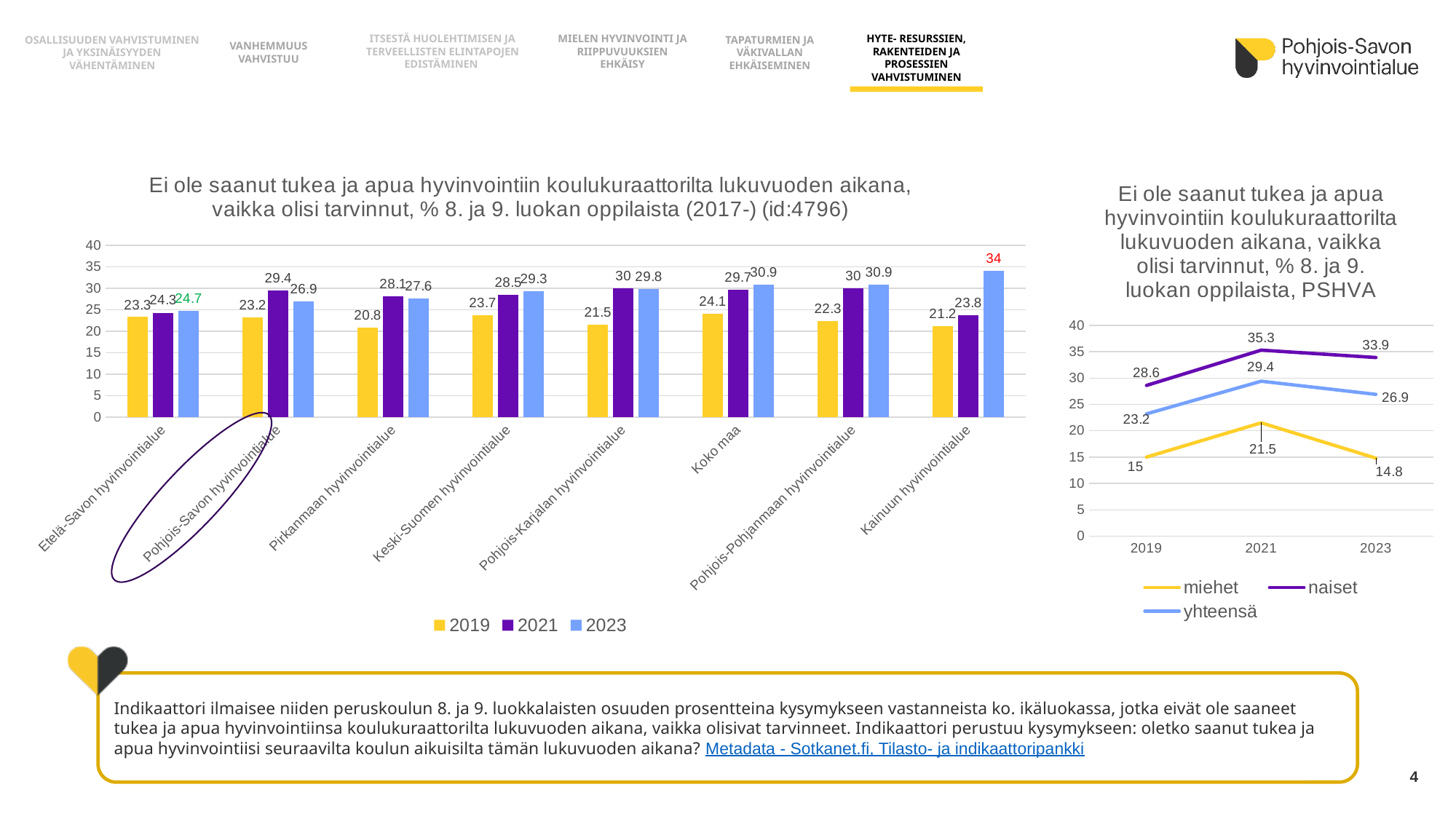
How many regions (categories) are shown in the left bar chart? 8 In the left bar chart, what is the 2021 value for Pohjois-Savon hyvinvointialue? 29.4 In the left bar chart, which region has the highest 2023 value? Kainuun hyvinvointialue In the right line chart, what is the value for naiset in 2021? 35.3 In the right line chart, what is the difference between naiset and miehet in 2023? 19.1 In the left bar chart, which region has the lowest 2019 value? Pirkanmaan hyvinvointialue How many series does the legend of the left bar chart list? 3 In the left bar chart, is the 2023 value for Koko maa larger or smaller than the 2023 value for Etelä-Savon hyvinvointialue? larger What type of chart is the chart on the right (PSHVA)? line chart In the left bar chart, what is the difference between the 2021 and 2019 values for Pirkanmaan hyvinvointialue? 7.3 In the right line chart, does the miehet line rise or fall from 2021 to 2023? fall In the left bar chart, what is the 2023 value for Kainuun hyvinvointialue? 34